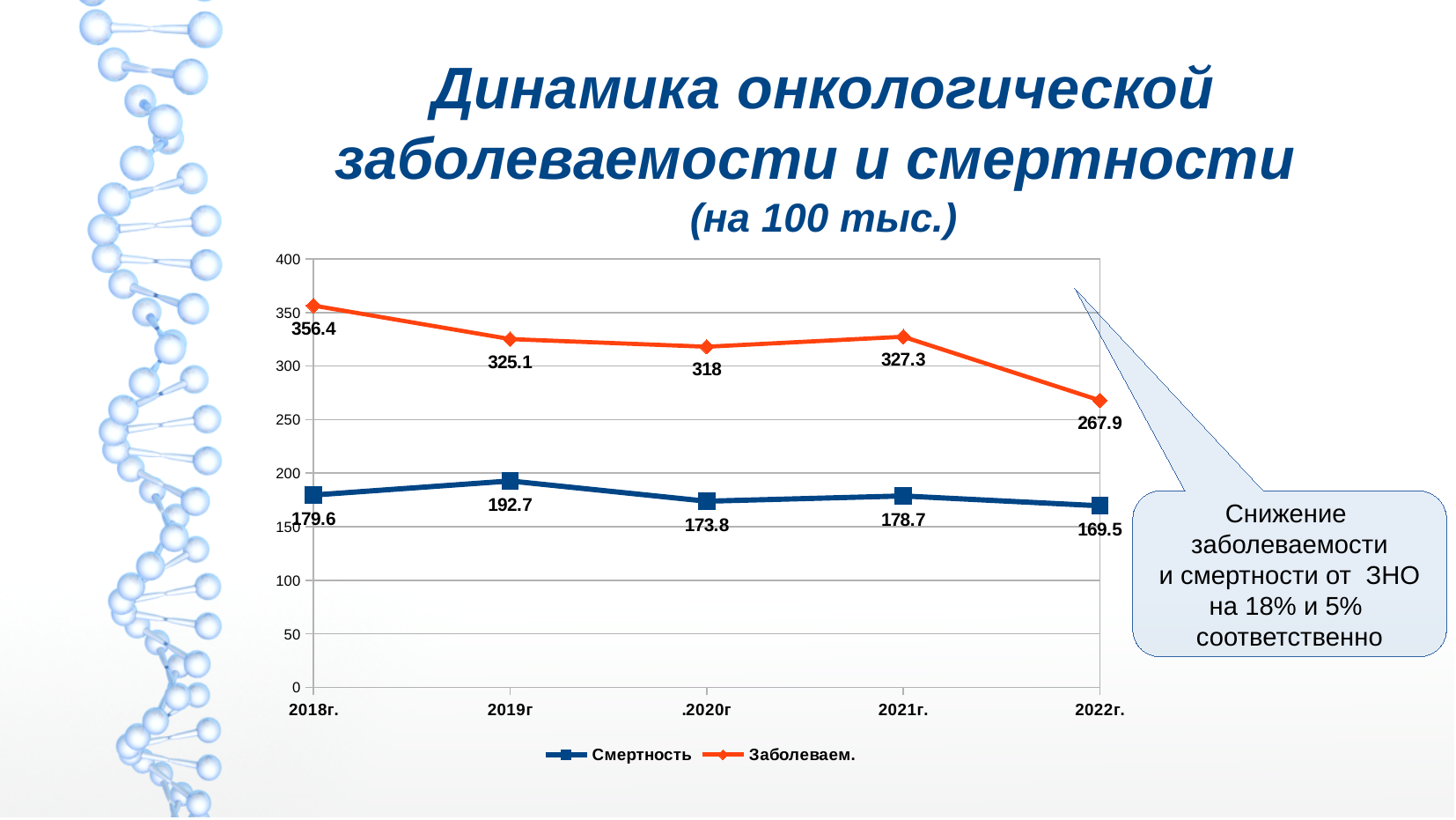
In which year is Заболеваем. highest? 2018г. What is the value of Заболеваем. for 2022г.? 267.9 What is the value of Смертность for 2020г? 173.8 Is the value of Заболеваем. for 2021г. greater or less than 300? greater How many series does the legend list? 2 Which is larger: Смертность in 2019г or Смертность in 2021г.? 2019г What is the value of Заболеваем. for 2018г.? 356.4 What is the difference between Заболеваем. in 2018г. and 2022г.? 88.5 What is the value of Смертность for 2019г? 192.7 How many years are shown on the x axis? 5 In which year is Смертность lowest? 2022г. What kind of chart is shown on the slide? line chart